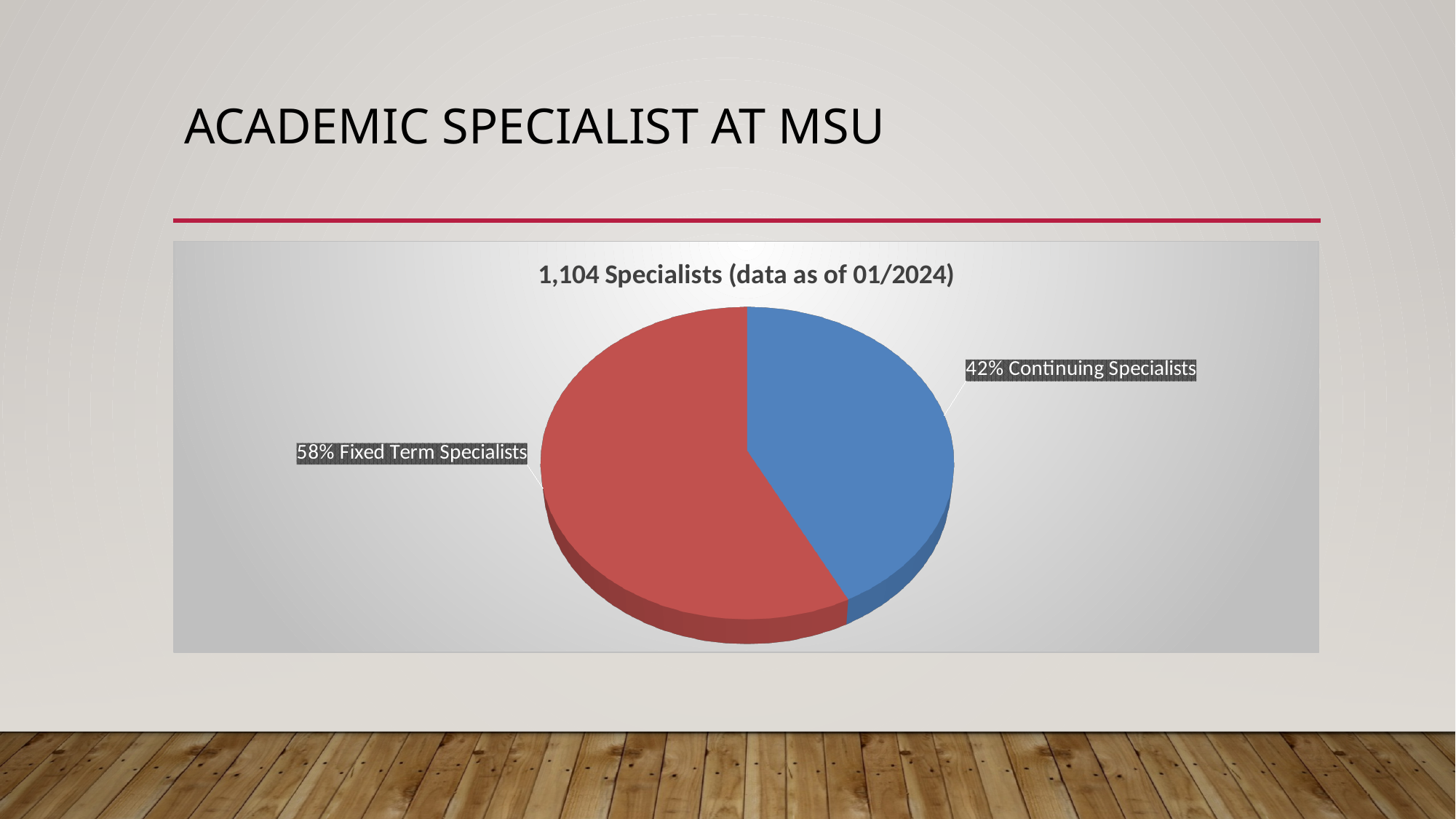
What kind of chart is shown on the slide? pie chart Is the share for Continuing Specialists greater or less than 50%? less Which is larger, the Fixed Term Specialists slice or the Continuing Specialists slice? Fixed Term Specialists What colour is the Fixed Term Specialists slice? red Which slice of the pie is the smallest? Continuing Specialists Which slice of the pie is the largest? Fixed Term Specialists What share of the pie is Continuing Specialists? 42% What is the difference in percentage points between the Fixed Term Specialists and Continuing Specialists slices? 16 How many slices does the pie chart have? 2 What share of the pie is Fixed Term Specialists? 58% What is the title of the chart? 1,104 Specialists (data as of 01/2024)